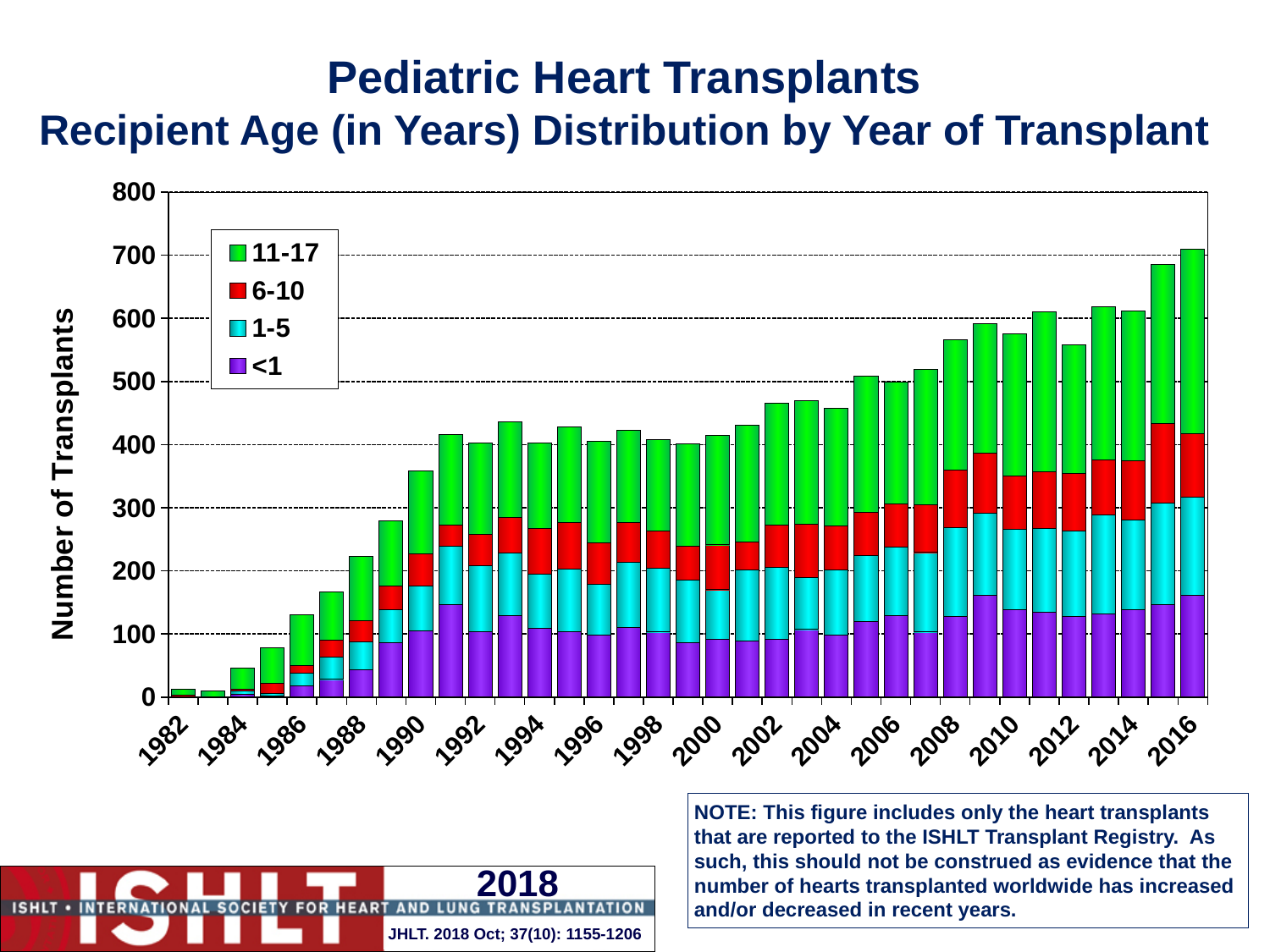
Is the total number of transplants in 1990 greater or less than 400? less Is the total number of transplants in 2008 greater or less than 500? greater What kind of chart is shown on the slide? stacked bar chart Which year has the larger total number of transplants, 2011 or 2012? 2011 Is the total number of transplants in 1986 greater or less than 100? greater Overall, do the total number of transplants rise or fall from 1982 to 2016? rise Which age group is shown in green in the legend? 11-17 Which year has the highest total number of transplants? 2016 How many series does the legend list? 4 What is the label of the y axis? Number of Transplants How many years (bars) are plotted on the x axis? 35